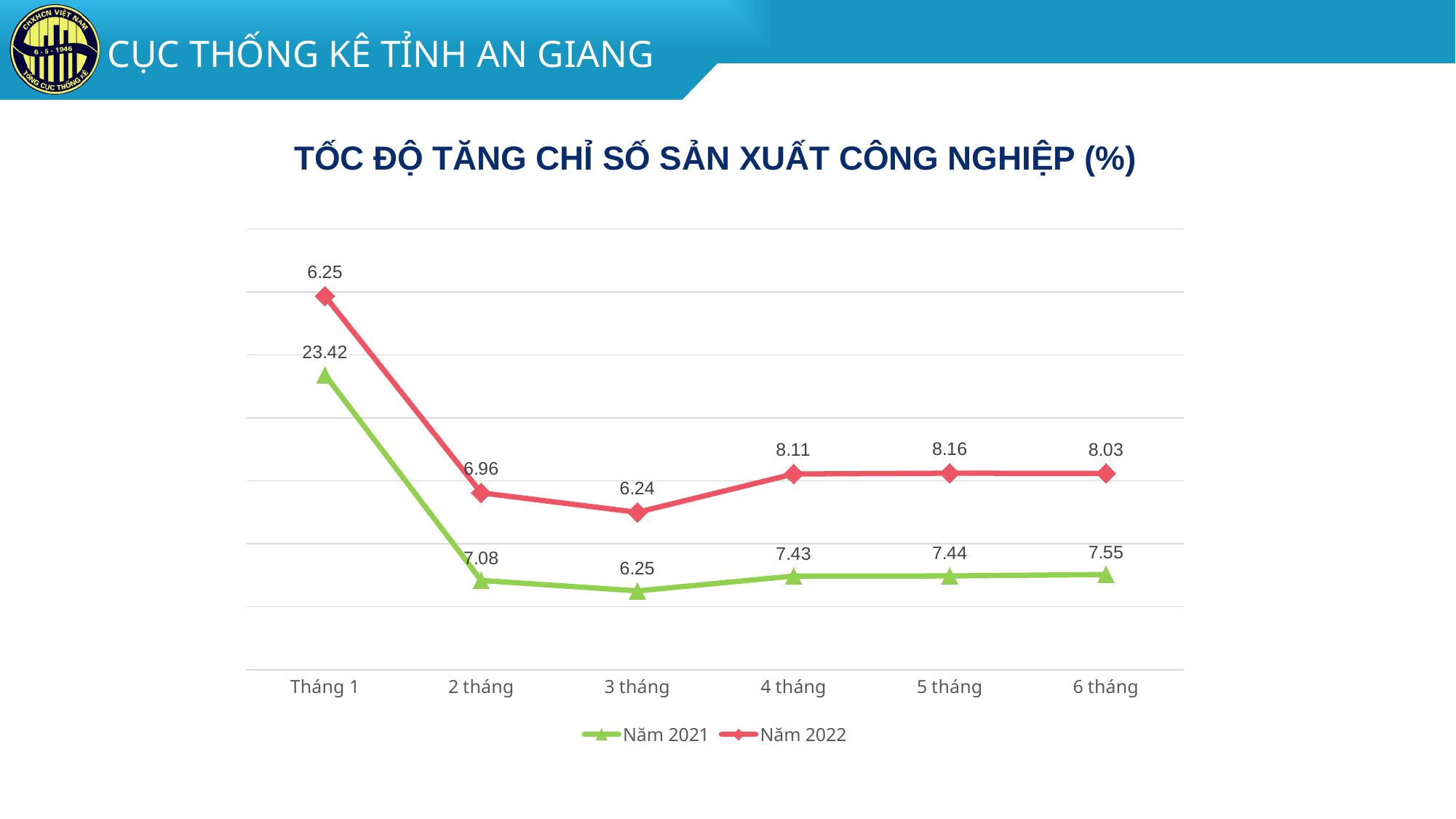
What is the value for Năm 2022 at 5 tháng? 8.16 What is the value for Năm 2021 at 4 tháng? 7.43 For Năm 2021, which is larger: the value at 2 tháng or at 6 tháng? 6 tháng Does the Năm 2021 series rise or fall from 3 tháng to 6 tháng? rise At which point is the Năm 2022 series highest? 5 tháng What kind of chart is shown on the slide? line chart How many series does the legend list? 2 What is the value for Năm 2022 at 3 tháng? 6.24 What is the difference between the Năm 2022 and Năm 2021 values at 6 tháng? 0.48 What is the value for Năm 2021 at 6 tháng? 7.55 How many time points are plotted along the x axis? 6 At which point is the Năm 2021 series lowest? 3 tháng